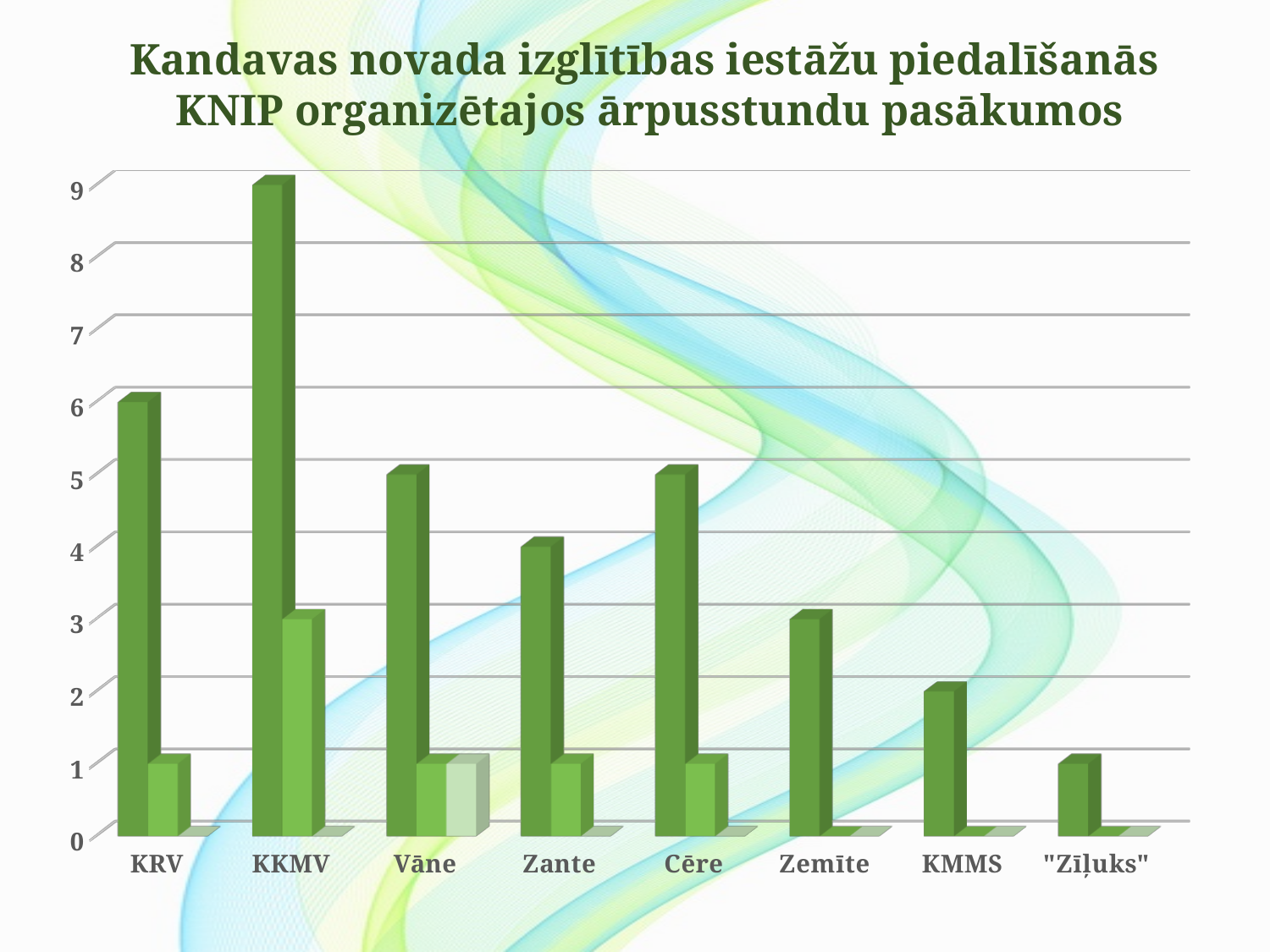
Which category has the shortest dark green bar? "Zīļuks" What is the difference between the dark green bars for KKMV and KRV? 3 Which has a taller dark green bar, KRV or Zante? KRV What is the value of the dark green bar for KRV? 6 Is the value of the dark green bar for Zemīte greater or less than 4? less What is the value of the dark green bar for KKMV? 9 What is the value of the light green bar for KKMV? 3 What type of chart is shown on the slide? bar chart What is the value of the dark green bar for Zante? 4 What is the title of the chart? Kandavas novada izglītības iestāžu piedalīšanās KNIP organizētajos ārpusstundu pasākumos How many categories are shown on the x axis of the chart? 8 Which category has the tallest dark green bar? KKMV